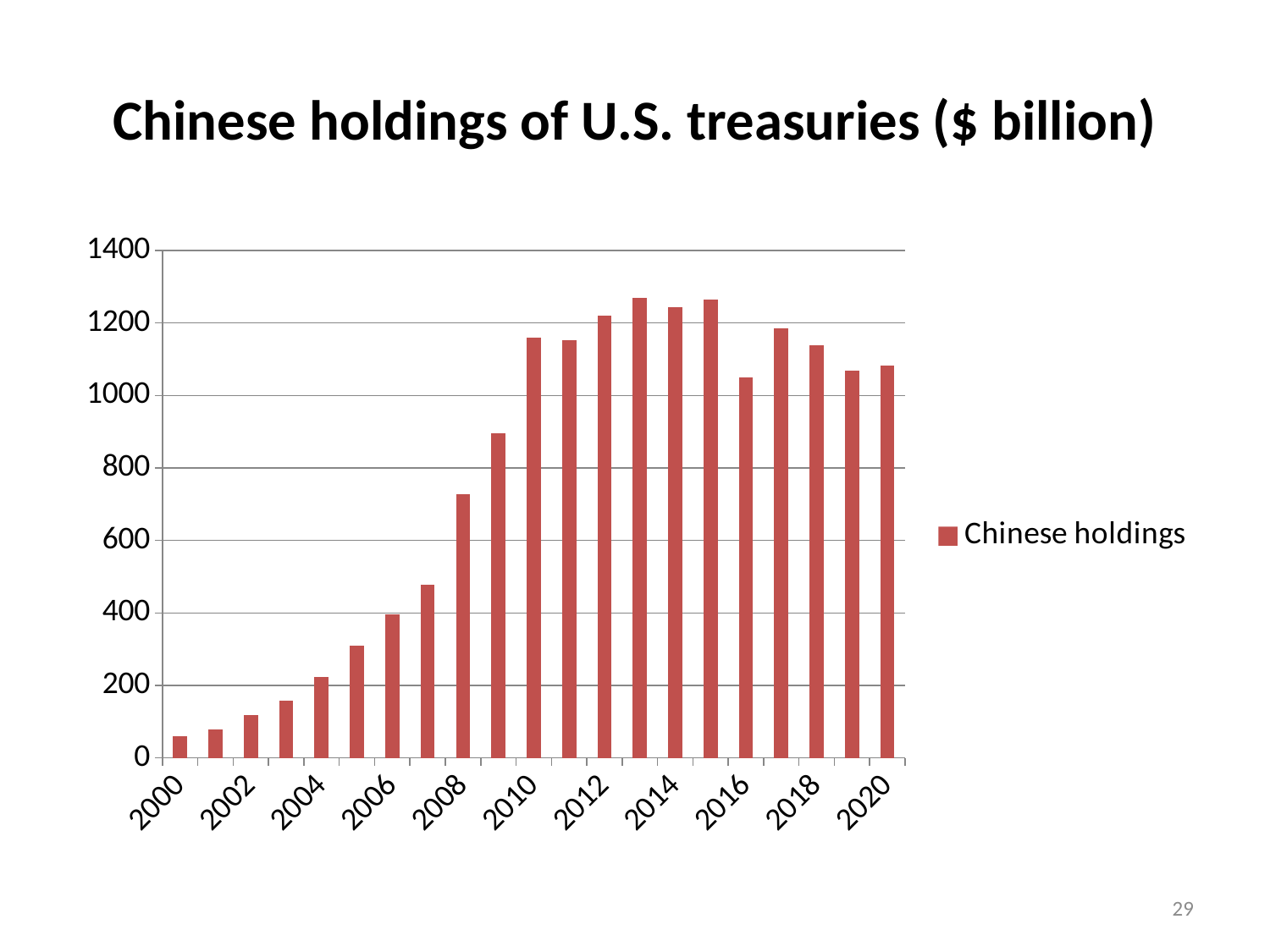
Do the values rise or fall from 2000 to 2010? rise Is the value for 2008 greater or less than 800? less What kind of chart is shown on the slide? bar chart Is the value for 2000 greater or less than 200? less Which year has the lowest Chinese holdings? 2000 How many series does the legend list? 1 How many years (bars) are plotted on the chart? 21 Is the value for 2007 greater or less than 600? less What is the title of the chart? Chinese holdings of U.S. treasuries ($ billion) Which is larger, the value for 2018 or the value for 2019? 2018 Which is larger, the value for 2010 or the value for 2005? 2010